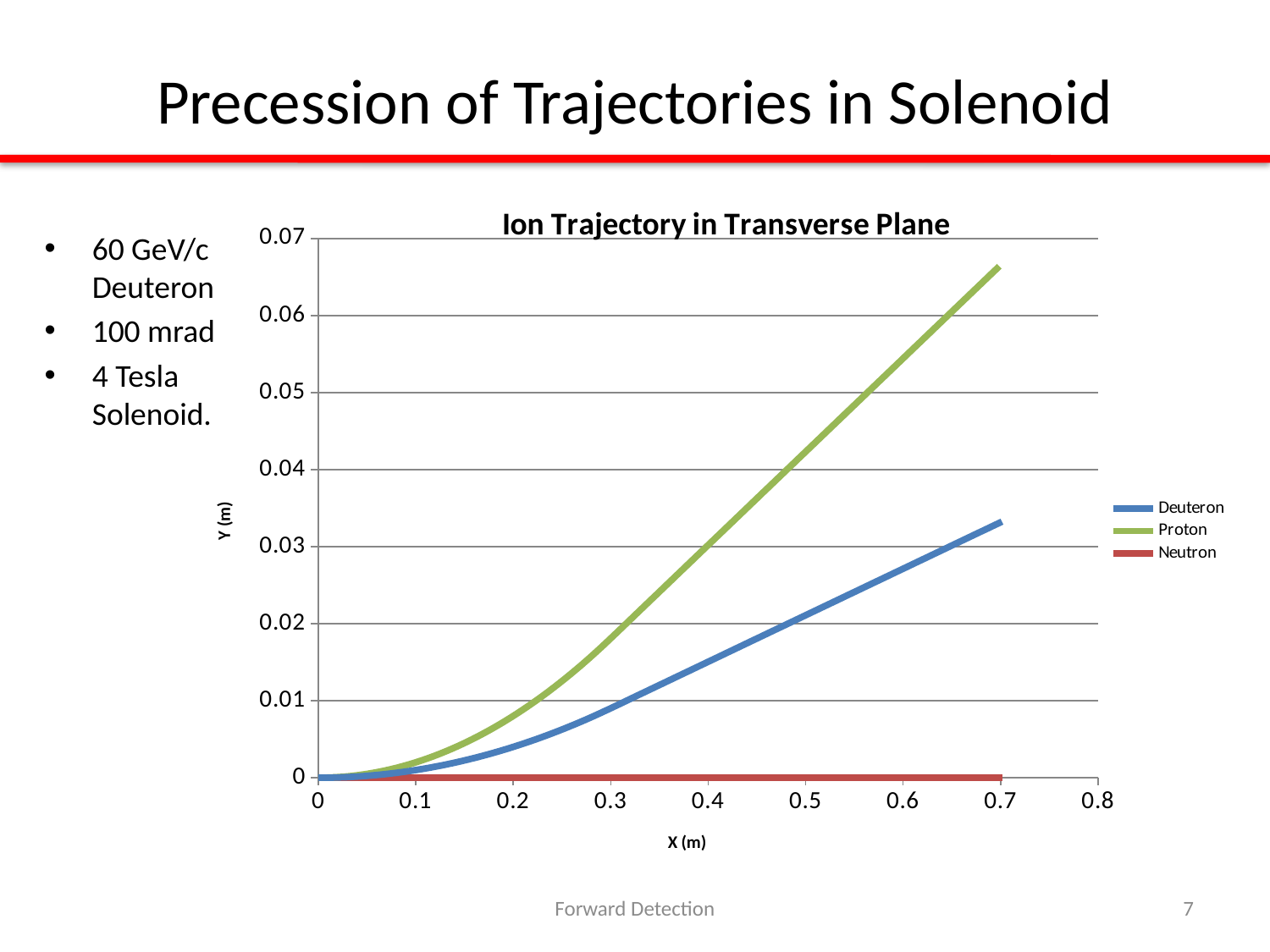
Is the Y value for Deuteron at X = 0.7 greater or less than 0.04? less What kind of chart is shown on the slide? line chart Does the Proton curve rise or fall as X increases? rise Which series has the larger Y value at X = 0.7, Deuteron or Proton? Proton Which series reaches the highest Y value on the chart? Proton How many series does the chart legend list? 3 Which series has the lowest Y values on the chart? Neutron Is the Y value for Deuteron at X = 0.4 greater or less than 0.02? less What is the title of the chart? Ion Trajectory in Transverse Plane What is the Y value of the Neutron series at X = 0.7? 0 What label is on the x axis of the chart? X (m) Is the Y value for Proton at X = 0.7 greater or less than 0.06? greater